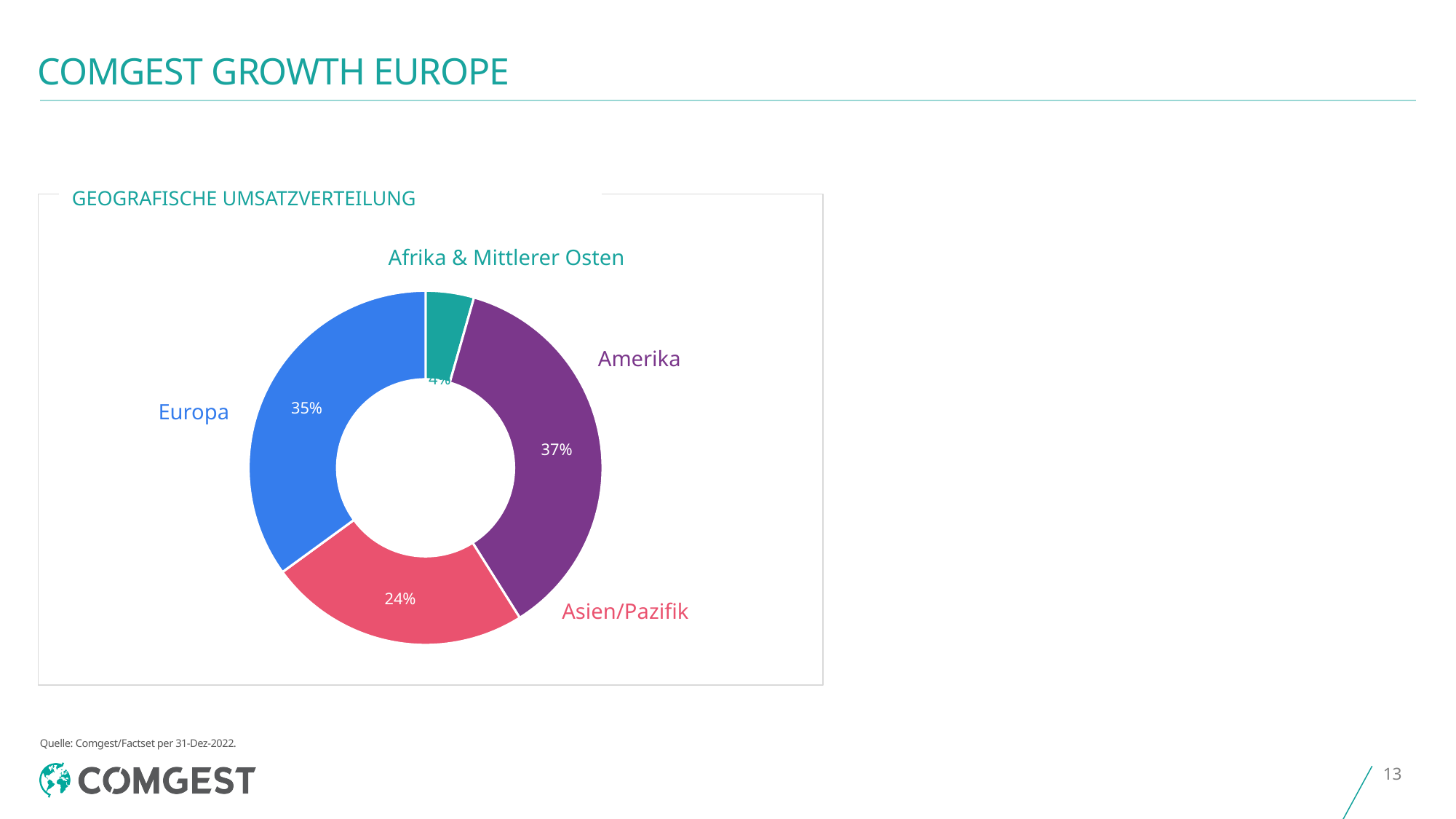
Which region has the largest share of revenue? Amerika What share of revenue does Afrika & Mittlerer Osten account for? 4% What share of revenue does Amerika account for in the Geografische Umsatzverteilung chart? 37% What type of chart is used to show the geographic revenue distribution? Pie chart (donut) What share of revenue does Europa account for? 35% How many regions are shown in the chart? 4 What share of revenue does Asien/Pazifik account for? 24% What is the difference in percentage points between the Amerika and Europa shares? 2 percentage points Which has a larger share, Asien/Pazifik or Europa? Europa What is the title of the chart? GEOGRAFISCHE UMSATZVERTEILUNG Which region has the smallest share of revenue? Afrika & Mittlerer Osten What is the difference in percentage points between the Europa and Asien/Pazifik shares? 11 percentage points